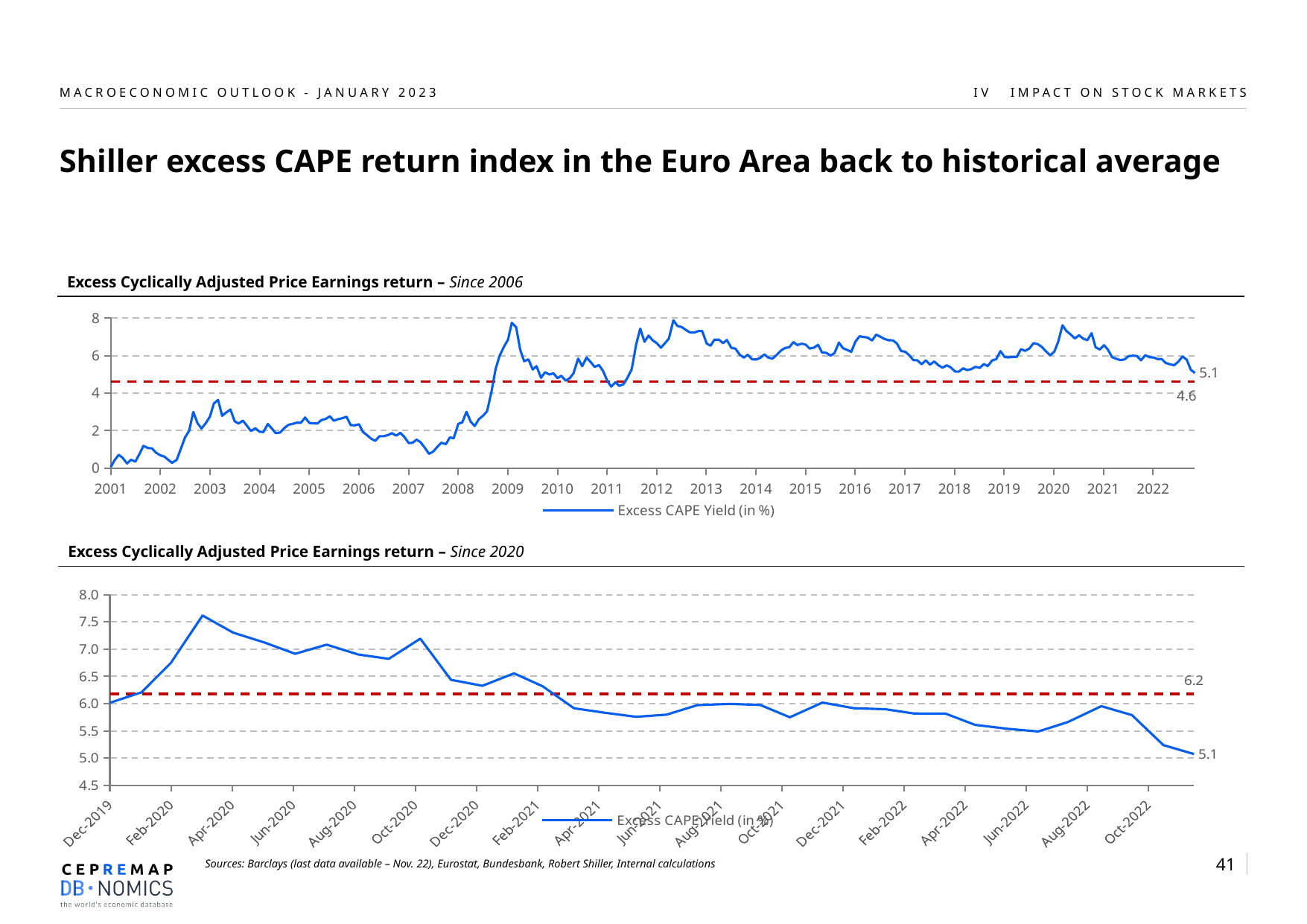
What kind of chart is the top chart, 'Excess Cyclically Adjusted Price Earnings return – Since 2006'? line chart In the bottom chart (Since 2020), what value is labelled on the red dashed horizontal line? 6.2 In the bottom chart (Since 2020), is the Excess CAPE Yield value in Apr-2020 greater or less than 7.0? greater In the bottom chart (Since 2020), does the Excess CAPE Yield rise or fall between Aug-2022 and the end of the series? fall In the top chart (Since 2006), what is the latest value labelled at the end of the Excess CAPE Yield line? 5.1 In the bottom chart (Since 2020), what is the difference between the dashed line value (6.2) and the latest value (5.1)? 1.1 What series name does the legend of the top chart (Since 2006) show? Excess CAPE Yield (in %) In the top chart (Since 2006), what is the difference between the latest value (5.1) and the dashed line value (4.6)? 0.5 In the bottom chart (Since 2020), what is the latest value labelled at the end of the Excess CAPE Yield line? 5.1 In the bottom chart (Since 2020), which is larger: the value in Apr-2020 or the value in Oct-2022? Apr-2020 In the top chart (Since 2006), what value is labelled on the red dashed horizontal line? 4.6